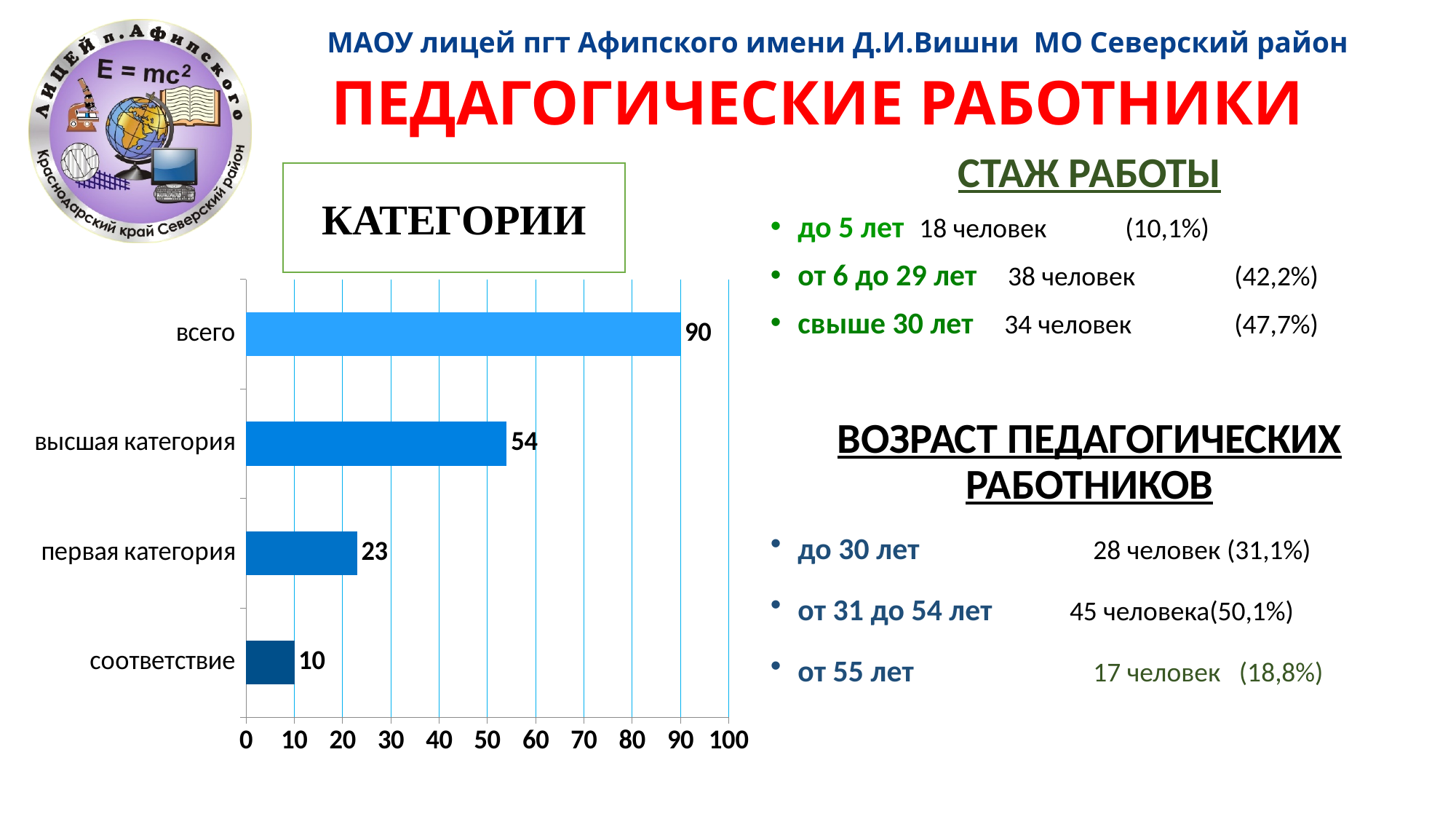
Which category has the lowest value in the КАТЕГОРИИ chart? соответствие Which category has the highest value in the КАТЕГОРИИ chart? всего What is the value for 'первая категория' in the КАТЕГОРИИ chart? 23 What is the value for 'высшая категория' in the КАТЕГОРИИ chart? 54 What is the maximum value shown on the x axis of the КАТЕГОРИИ chart? 100 What is the value for 'соответствие' in the КАТЕГОРИИ chart? 10 What is the difference between 'высшая категория' and 'первая категория' in the КАТЕГОРИИ chart? 31 What is the value for 'всего' in the КАТЕГОРИИ chart? 90 How many categories are shown in the КАТЕГОРИИ chart? 4 What kind of chart is the КАТЕГОРИИ chart? bar chart Which is larger in the КАТЕГОРИИ chart: 'первая категория' or 'соответствие'? первая категория Is the value for 'высшая категория' greater or less than 50? greater